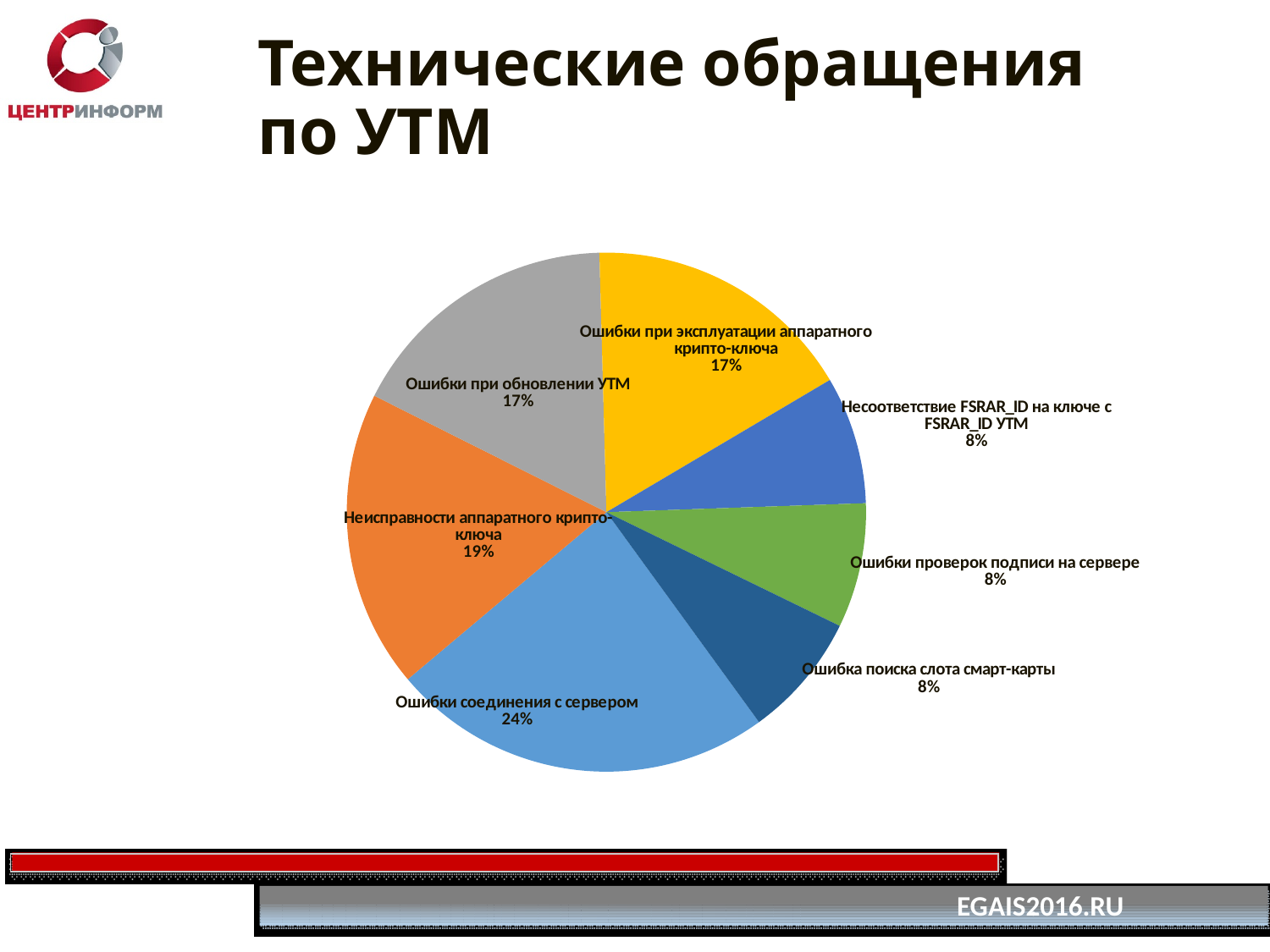
What share of the pie is "Ошибка поиска слота смарт-карты"? 8% What share of the pie is "Ошибки при обновлении УТМ"? 17% Which category has the largest share of the pie? Ошибки соединения с сервером What kind of chart is shown on the slide? Pie chart What share of the pie is "Ошибки соединения с сервером"? 24% What is the difference between the shares of "Ошибки соединения с сервером" and "Неисправности аппаратного крипто-ключа"? 5% What is the difference between the shares of "Ошибки при обновлении УТМ" and "Ошибки проверок подписи на сервере"? 9% How many slices does the pie chart have? 7 Which is larger: the share of "Неисправности аппаратного крипто-ключа" or the share of "Ошибки при эксплуатации аппаратного крипто-ключа"? Неисправности аппаратного крипто-ключа What is the title of the slide containing the pie chart? Технические обращения по УТМ